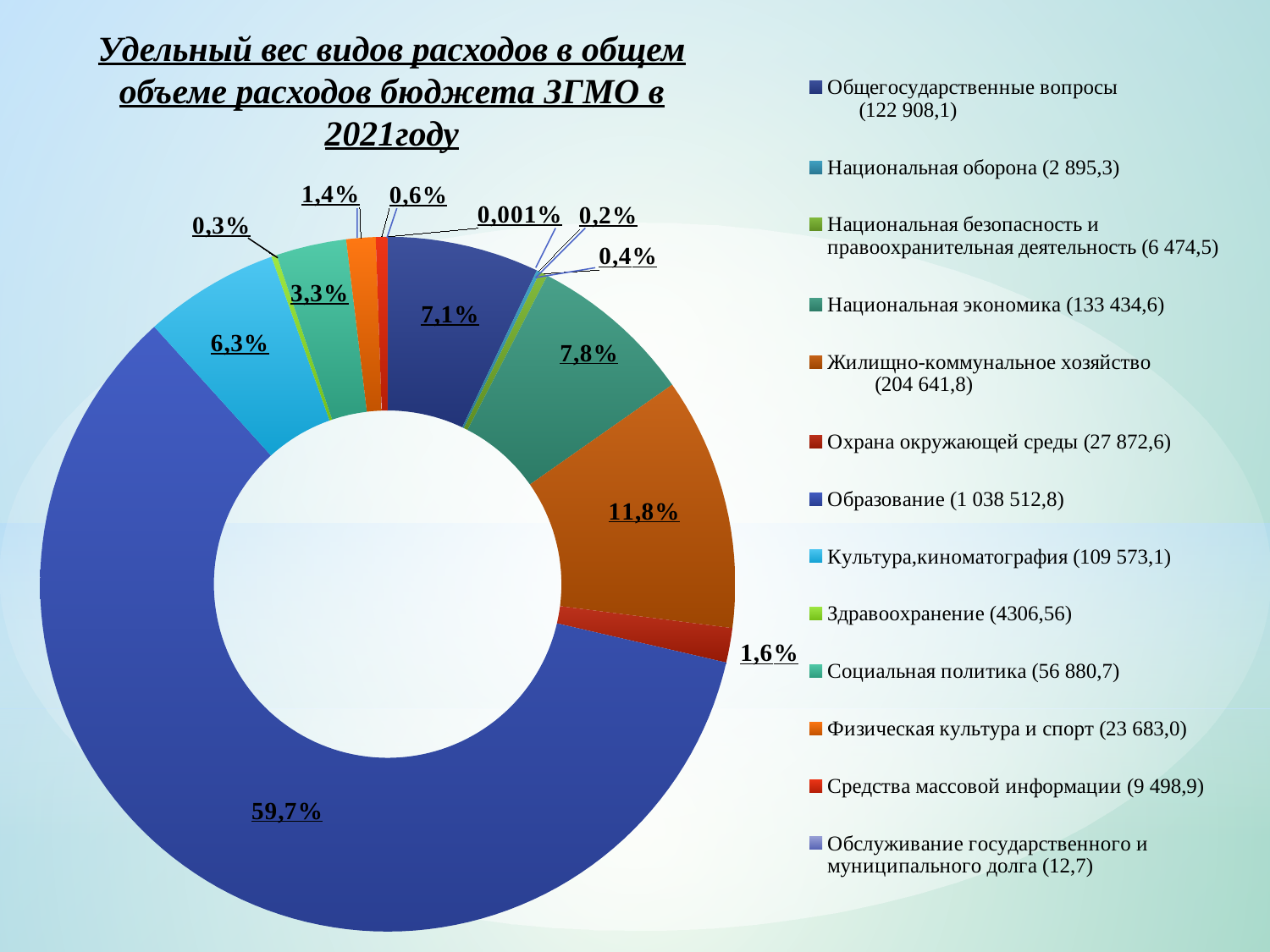
What is the smallest percentage label shown on the chart? 0,001% Which has a larger share: Общегосударственные вопросы or Национальная экономика? Национальная экономика What share of expenditures does Жилищно-коммунальное хозяйство account for? 11,8% What amount is shown in the legend for Образование? 1 038 512,8 What is the difference in percentage points between the shares of Образование and Жилищно-коммунальное хозяйство? 47,9% How many categories does the legend list? 13 What year does the chart title refer to? 2021 What share of expenditures does Образование account for? 59,7% What share of expenditures does Культура,кинематография account for? 6,3% Which category has the largest share of the budget expenditures? Образование What kind of chart is shown on the slide? Doughnut (pie) chart